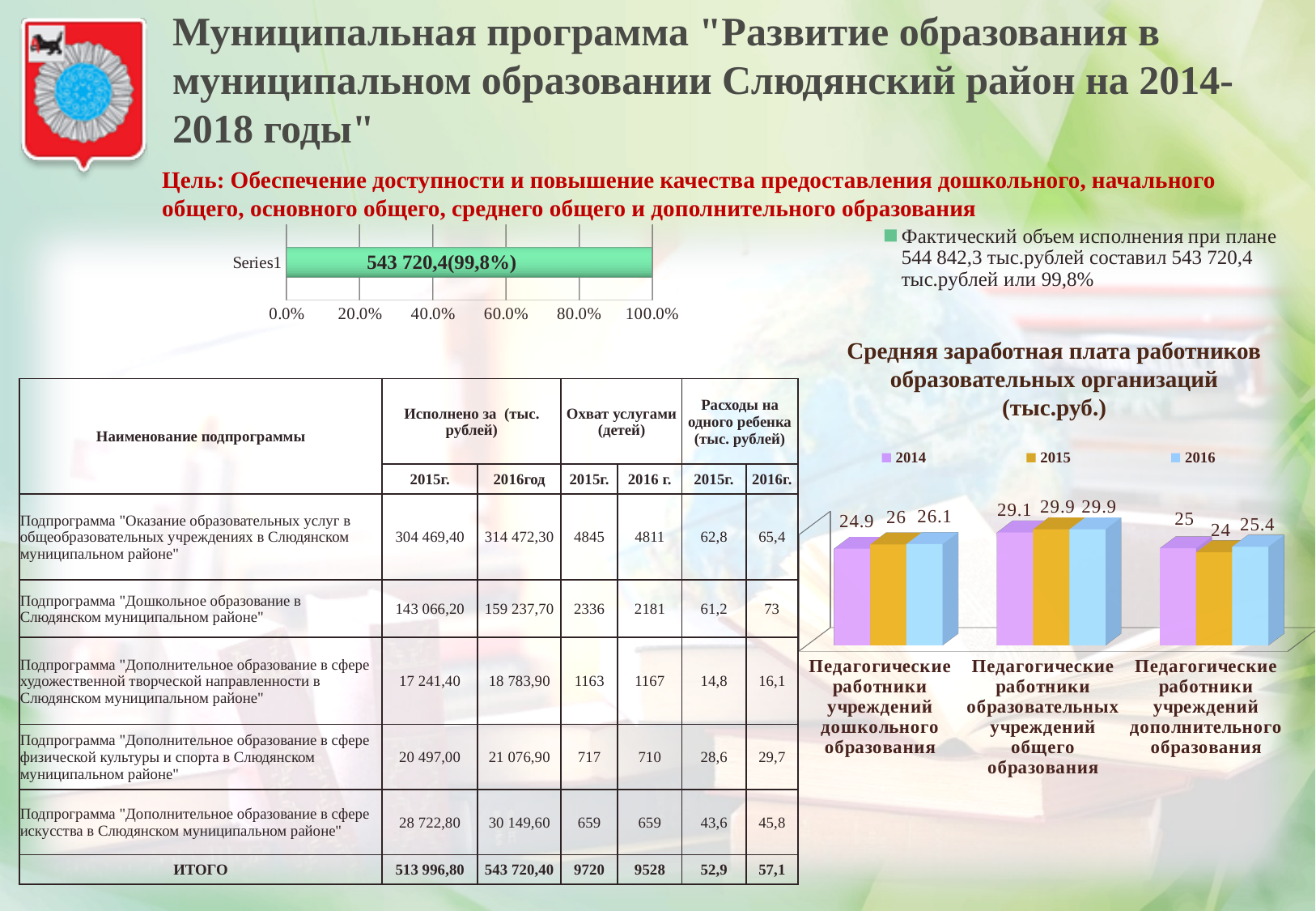
What is the data label shown on the bar in the small horizontal bar chart at the top of the slide? 543 720,4(99,8%) On the chart 'Средняя заработная плата работников образовательных организаций (тыс.руб.)', what is the 2016 value for Педагогические работники учреждений дополнительного образования? 25.4 On the chart 'Средняя заработная плата работников образовательных организаций (тыс.руб.)', which category has the lowest 2015 value? Педагогические работники учреждений дополнительного образования On the chart 'Средняя заработная плата работников образовательных организаций (тыс.руб.)', what is the difference between the 2016 and 2014 values for Педагогические работники учреждений дошкольного образования? 1.2 On the chart 'Средняя заработная плата работников образовательных организаций (тыс.руб.)', which is larger for Педагогические работники учреждений дополнительного образования: the 2014 value or the 2015 value? 2014 On the chart 'Средняя заработная плата работников образовательных организаций (тыс.руб.)', what is the 2015 value for Педагогические работники образовательных учреждений общего образования? 29.9 On the chart 'Средняя заработная плата работников образовательных организаций (тыс.руб.)', what is the 2014 value for Педагогические работники учреждений дошкольного образования? 24.9 On the chart 'Средняя заработная плата работников образовательных организаций (тыс.руб.)', how many series does the legend list? 3 What kind of chart is 'Средняя заработная плата работников образовательных организаций (тыс.руб.)'? Bar chart On the chart 'Средняя заработная плата работников образовательных организаций (тыс.руб.)', do the values for Педагогические работники учреждений дошкольного образования rise or fall from 2014 to 2016? Rise On the chart 'Средняя заработная плата работников образовательных организаций (тыс.руб.)', which category has the highest 2014 value? Педагогические работники образовательных учреждений общего образования On the chart 'Средняя заработная плата работников образовательных организаций (тыс.руб.)', how many categories are shown on the x axis? 3